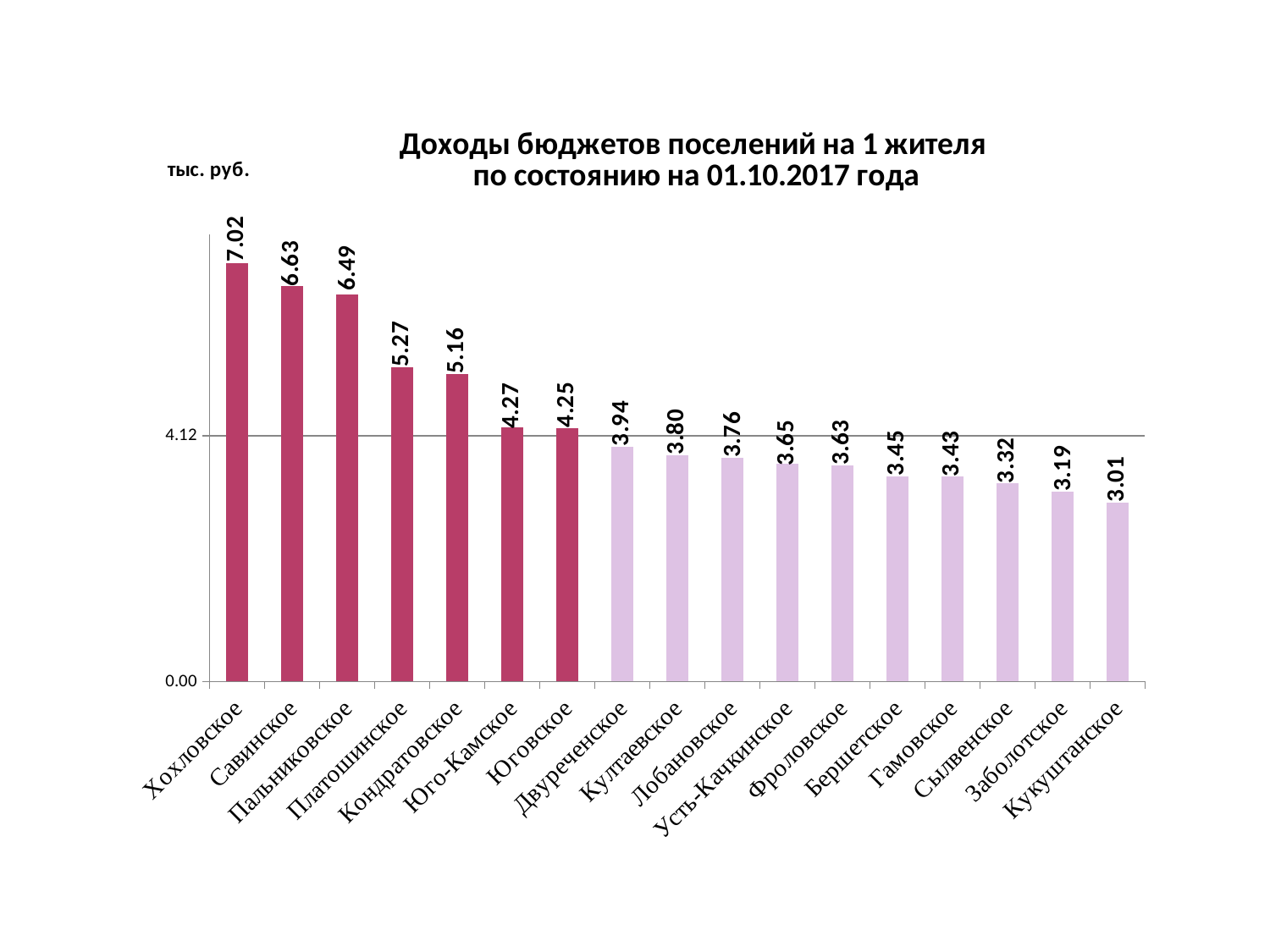
What is the value for Кондратовское? 5.16 Which is larger, the value for Платошинское or the value for Двуреченское? Платошинское Which settlement has the lowest value? Кукуштанское How many settlements are shown on the chart? 17 What unit is indicated for the values on the chart? тыс. руб. What is the difference between the values for Савинское and Пальниковское? 0.14 What is the value for Фроловское? 3.63 What is the value for Хохловское? 7.02 What kind of chart is shown on the slide? bar chart Which settlement has the highest value? Хохловское What is the difference between the values for Хохловское and Кукуштанское? 4.01 Is the value for Култаевское greater or less than 4.12? less